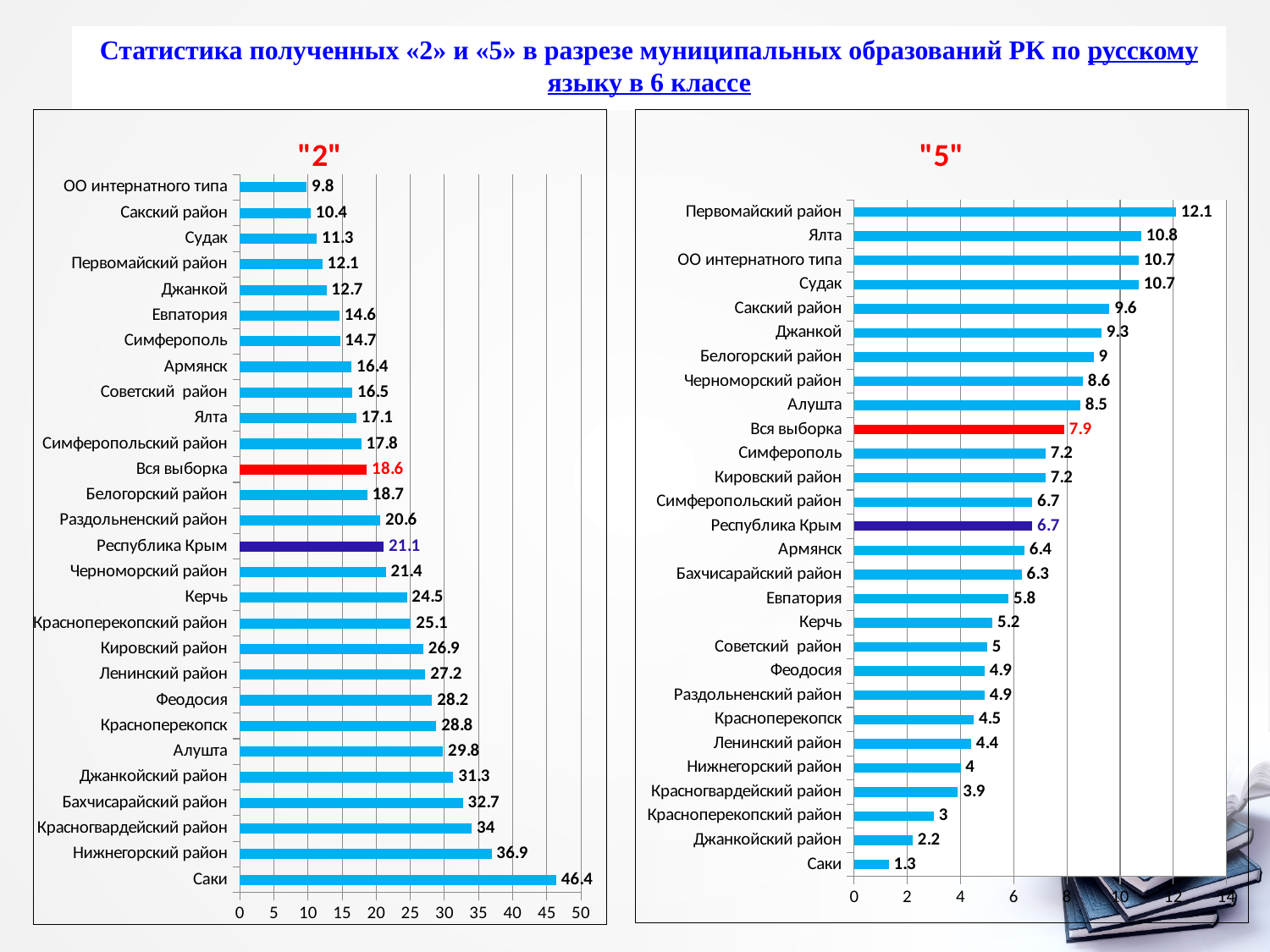
How many categories are shown in the "5" chart? 28 In the "5" chart, is the value for Джанкой greater or less than 8? greater In the "5" chart, which category has the highest value? Первомайский район What type of chart is the "2" chart? bar chart In the "5" chart, which category has the lowest value? Саки In the "2" chart, what is the value for Вся выборка? 18.6 In the "2" chart, which is larger: the value for Керчь or the value for Феодосия? Феодосия In the "5" chart, what is the value for Республика Крым? 6.7 In the "2" chart, which category has the lowest value? ОО интернатного типа In the "2" chart, what is the value for Саки? 46.4 In the "5" chart, what is the difference between the values for Ялта and Вся выборка? 2.9 In the "2" chart, what is the difference between the values for Саки and Нижнегорский район? 9.5